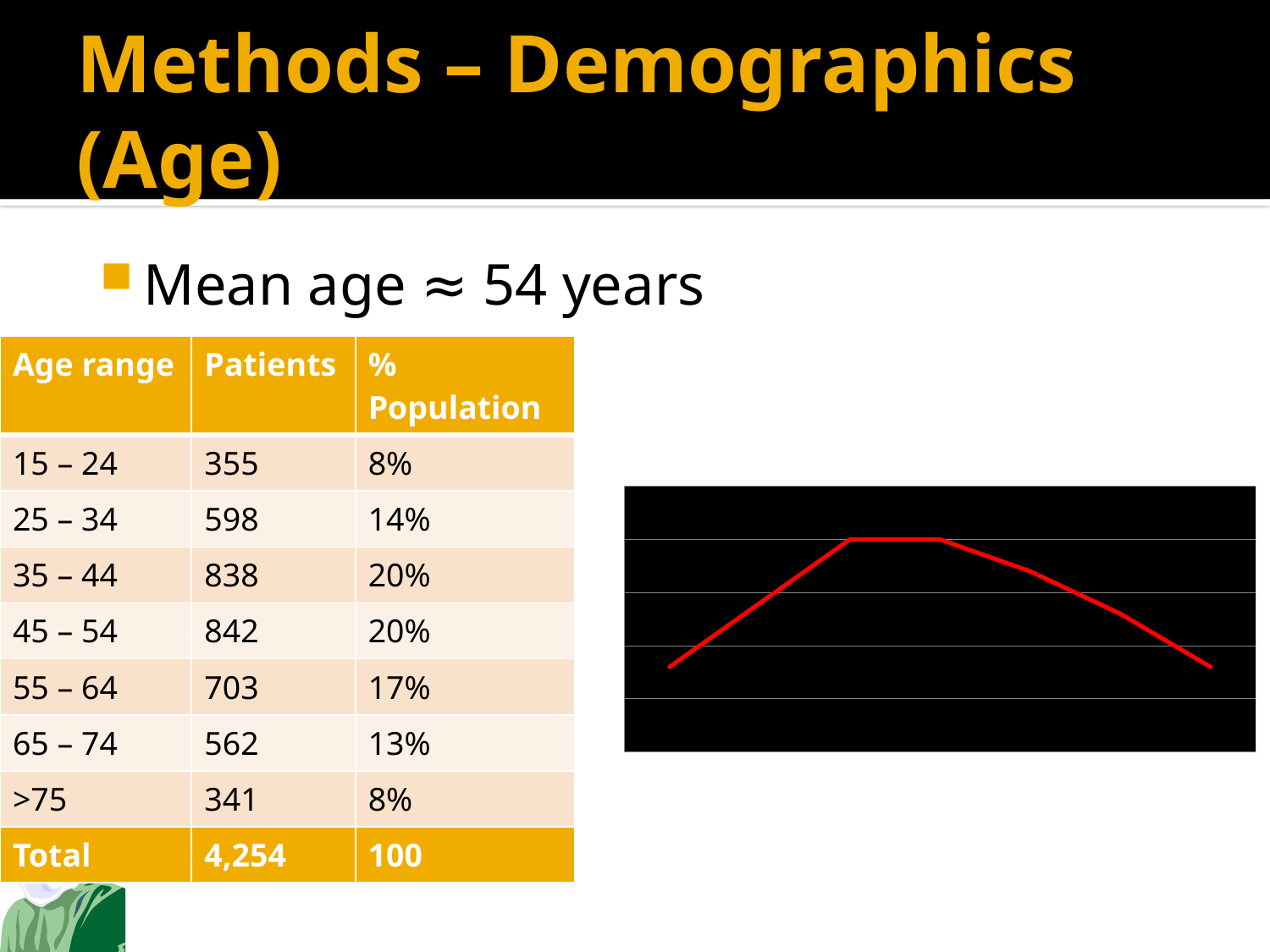
Overall, does the line on the chart rise then fall, or fall then rise, along the x axis? rise then fall Does the line rise or fall from its first point to its highest point? rise How many lines are plotted on the chart? 1 Does the chart display a legend? No Does the line rise or fall from its highest point to its last point? fall What colour is the line on the chart? red Is the highest part of the line at the left end, in the middle, or at the right end of the chart? in the middle What kind of chart is shown on the right side of the slide? line chart